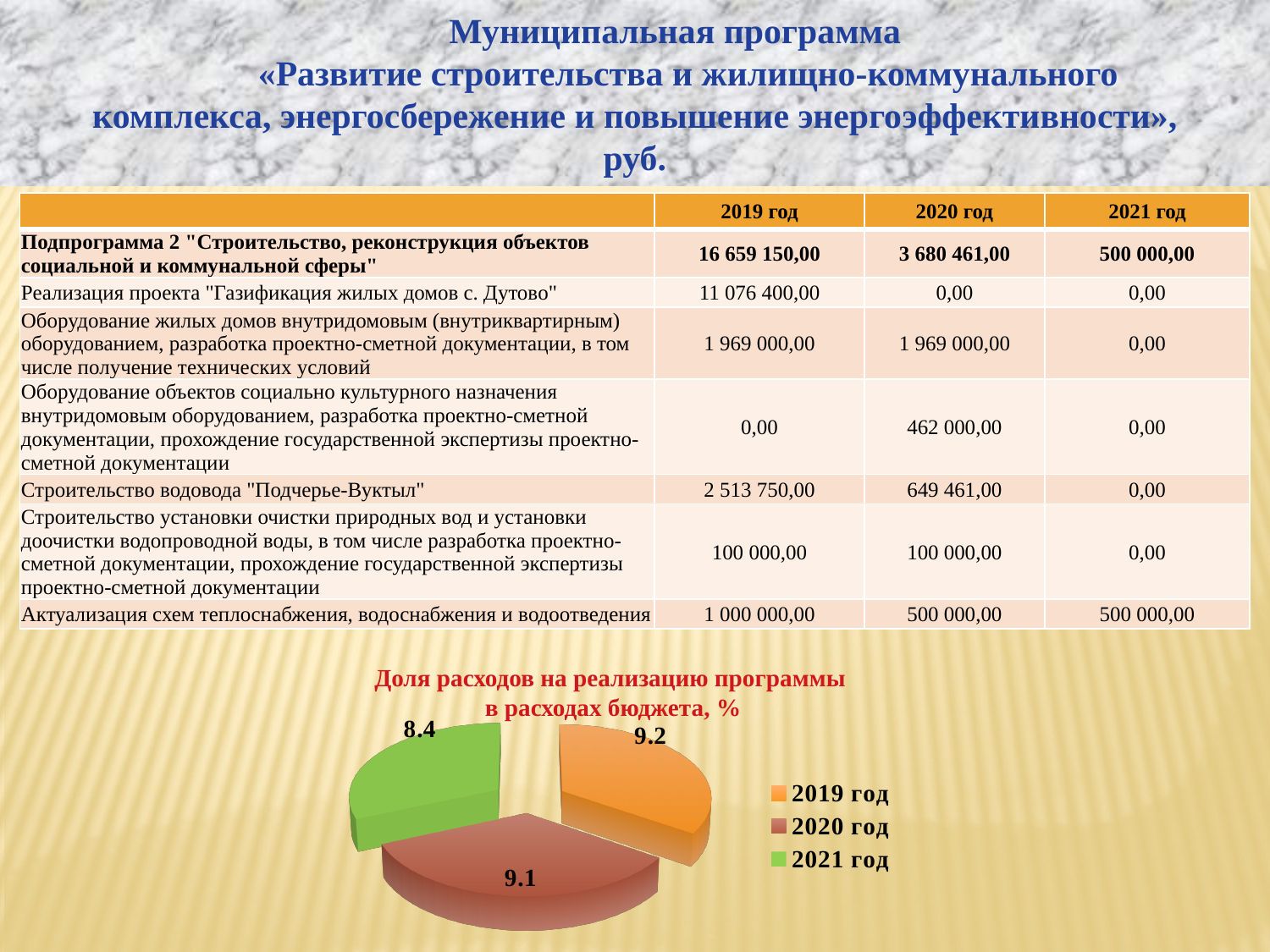
How many slices does the pie chart have? 3 What is the difference between the values for 2019 год and 2021 год in the pie chart? 0.8 How many entries does the pie chart legend list? 3 What is the value for 2021 год in the pie chart? 8.4 What is the difference between the values for 2020 год and 2021 год in the pie chart? 0.7 What colour is the slice for 2021 год in the pie chart? Green Which year has the smallest slice in the pie chart? 2021 год What is the value for 2020 год in the pie chart? 9.1 Which is larger in the pie chart, the value for 2019 год or 2020 год? 2019 год Which year has the largest slice in the pie chart? 2019 год What type of chart is shown on the slide? Pie chart What is the value for 2019 год in the pie chart? 9.2